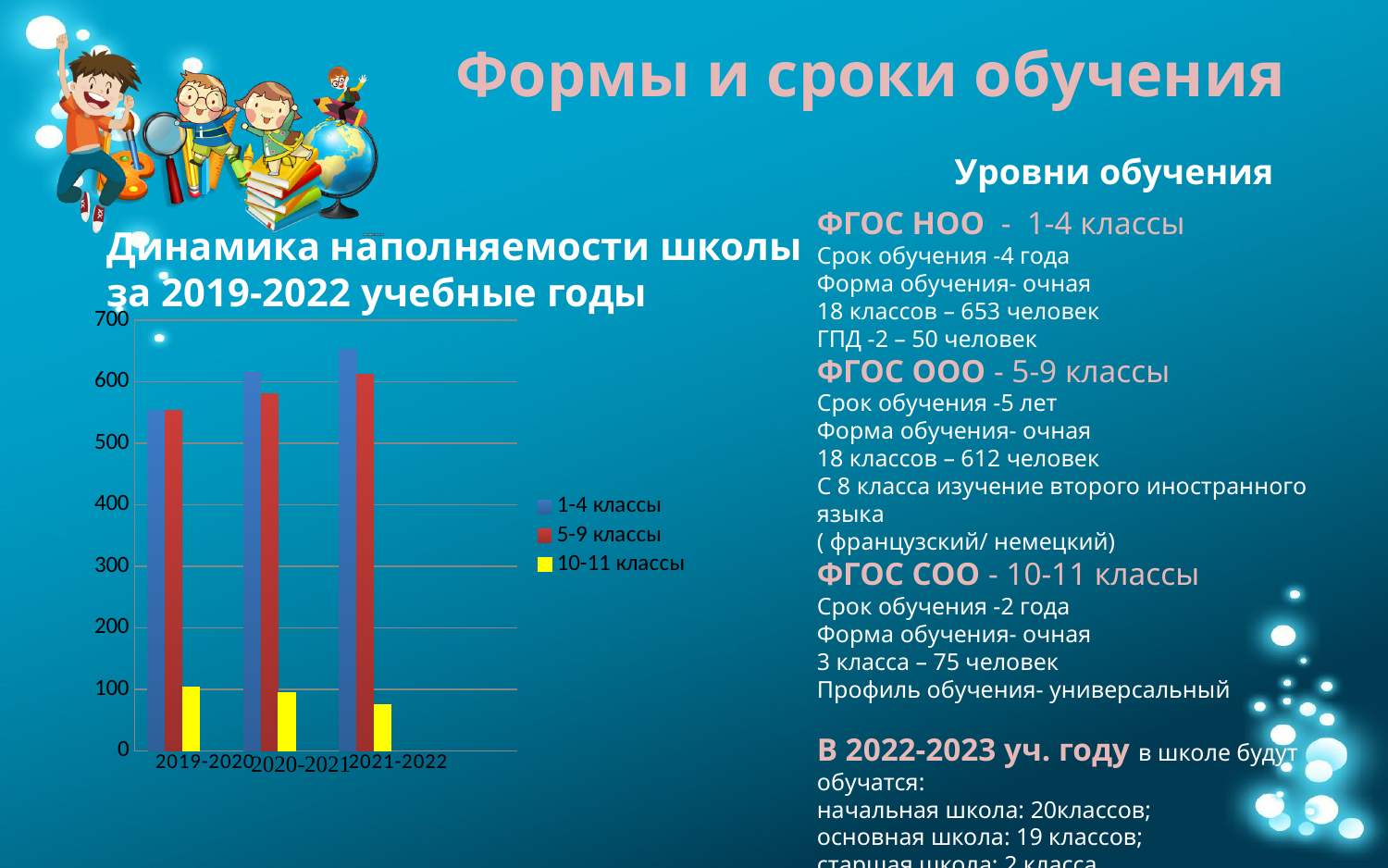
Does the value for 1-4 классы rise or fall from 2019-2020 to 2021-2022? rise What is the title of the chart? Динамика наполняемости школы за 2019-2022 учебные годы Is the value for 1-4 классы in 2021-2022 greater or less than 600? greater How many series does the chart legend list? 3 In which school year is the value for 1-4 классы the highest? 2021-2022 What kind of chart is shown on the slide? bar chart How many school years are shown on the x axis of the chart? 3 Is the value for 5-9 классы in 2019-2020 greater or less than 500? greater Is the value for 10-11 классы in 2019-2020 greater or less than 200? less In which school year is the value for 10-11 классы the lowest? 2021-2022 Which series is shown in yellow in the chart? 10-11 классы